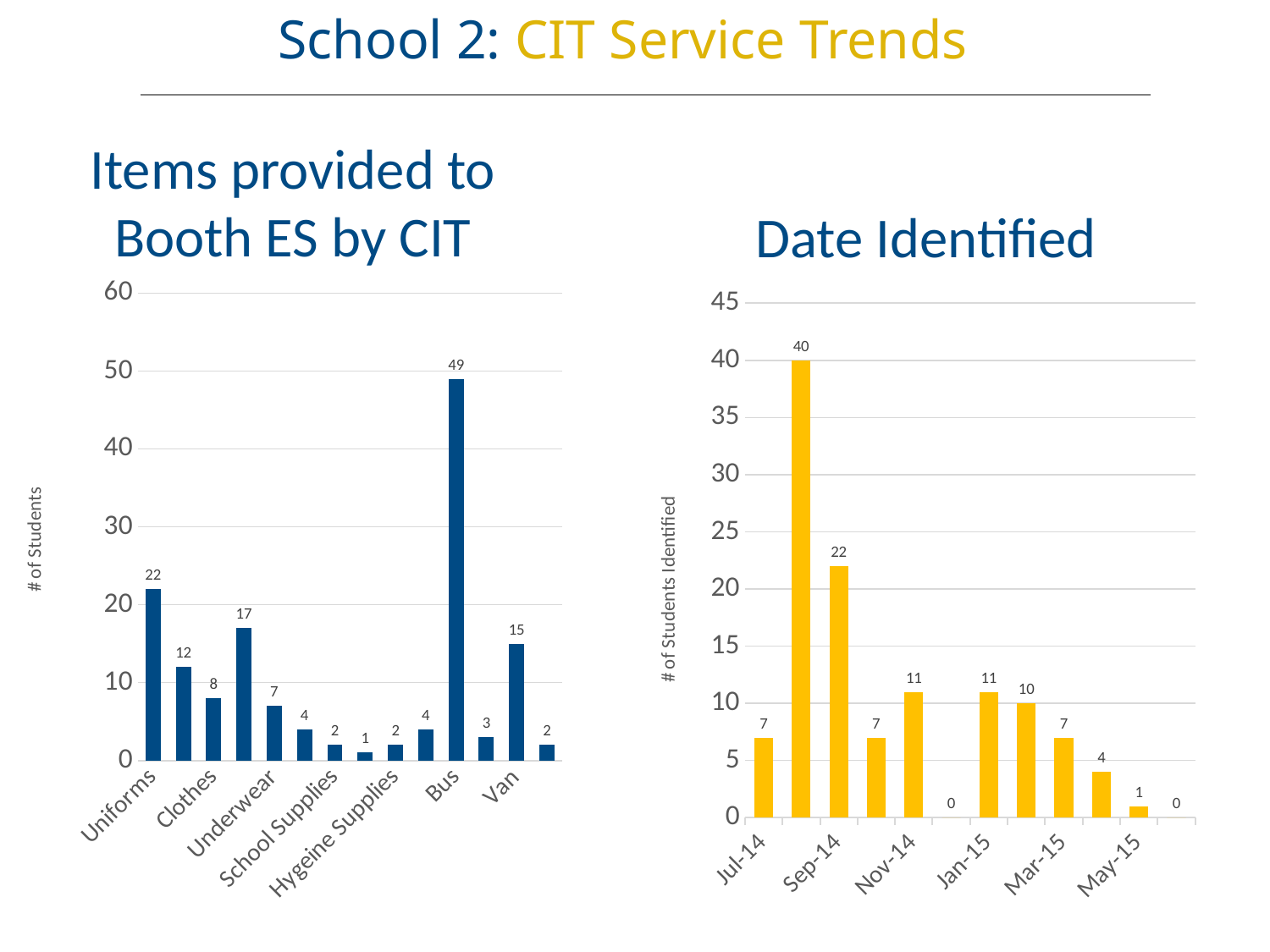
In the 'Items provided to Booth ES by CIT' chart, what is the value for Bus? 49 In the 'Date Identified' chart, what is the highest value shown on any bar? 40 In the 'Items provided to Booth ES by CIT' chart, how many bars are plotted? 14 In the 'Date Identified' chart, what is the value for Sep-14? 22 In the 'Items provided to Booth ES by CIT' chart, what is the value for Uniforms? 22 In the 'Items provided to Booth ES by CIT' chart, what is the difference between the values for Uniforms and Van? 7 In the 'Date Identified' chart, how many bars are plotted? 12 In the 'Date Identified' chart, what is the value for Jan-15? 11 In the 'Items provided to Booth ES by CIT' chart, which is larger, the value for Clothes or the value for Underwear? Clothes What kind of chart is the 'Date Identified' chart? Bar chart In the 'Date Identified' chart, what is the difference between the values for Sep-14 and Mar-15? 15 In the 'Items provided to Booth ES by CIT' chart, which category has the highest value? Bus